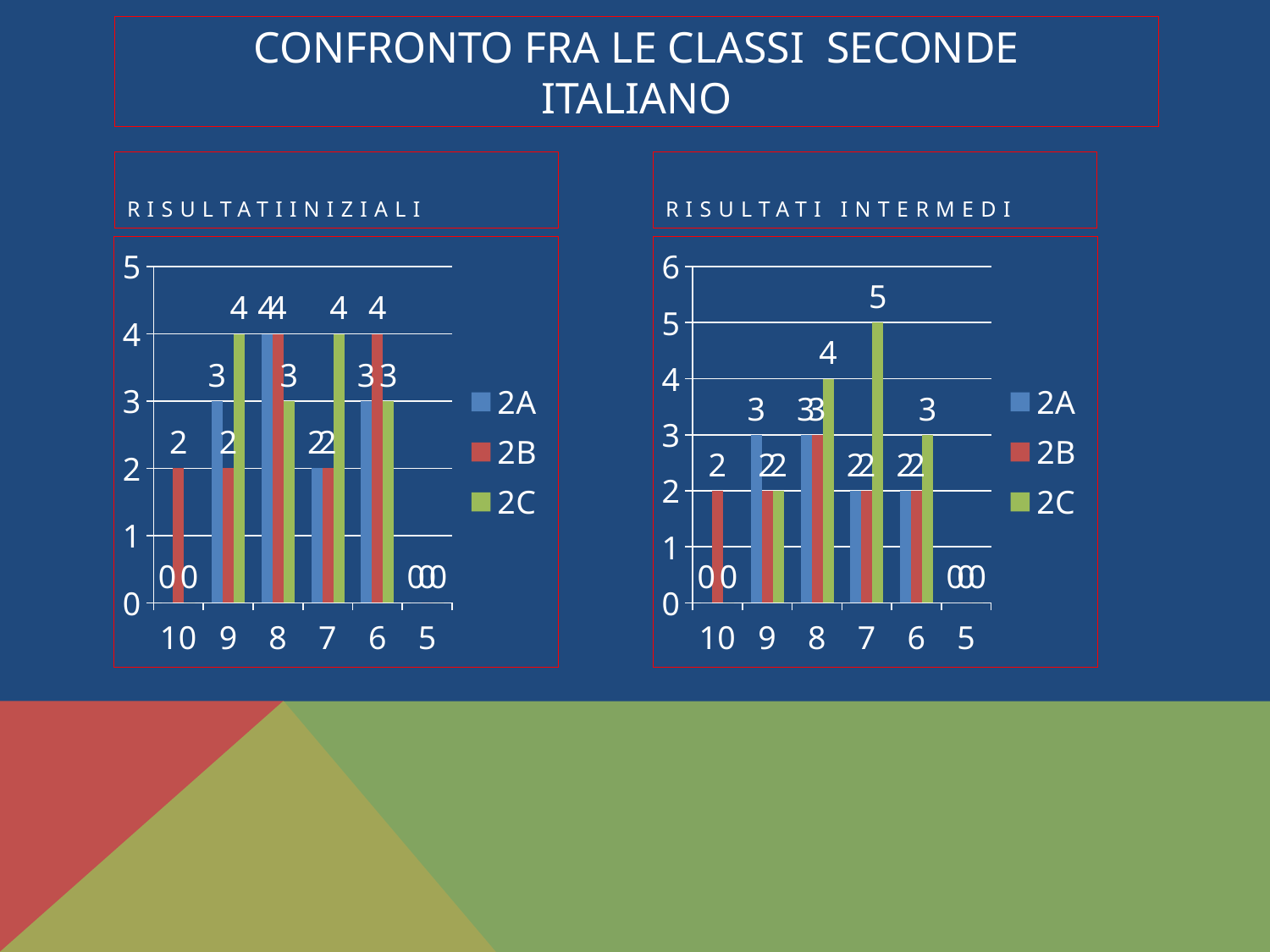
In the RISULTATI INIZIALI chart, which is larger at category 6: the value for 2B or the value for 2C? 2B In the RISULTATI INIZIALI chart, what is the value for 2C at category 9? 4 In the RISULTATI INTERMEDI chart, what is the value for 2C at category 7? 5 What kind of chart is the RISULTATI INTERMEDI chart? Bar chart In the RISULTATI INIZIALI chart, what is the value for 2B at category 10? 2 In the RISULTATI INIZIALI chart, what is the value for 2A at category 8? 4 How many categories are shown on the x axis of the RISULTATI INIZIALI chart? 6 How many series does the legend of the RISULTATI INTERMEDI chart list? 3 In the RISULTATI INTERMEDI chart, what is the value for 2A at category 9? 3 In the RISULTATI INIZIALI chart, what is the total of the three series at category 8? 11 In the RISULTATI INTERMEDI chart, which category has the highest value for 2C? 7 In the RISULTATI INTERMEDI chart, what is the difference between the 2C value and the 2A value at category 7? 3